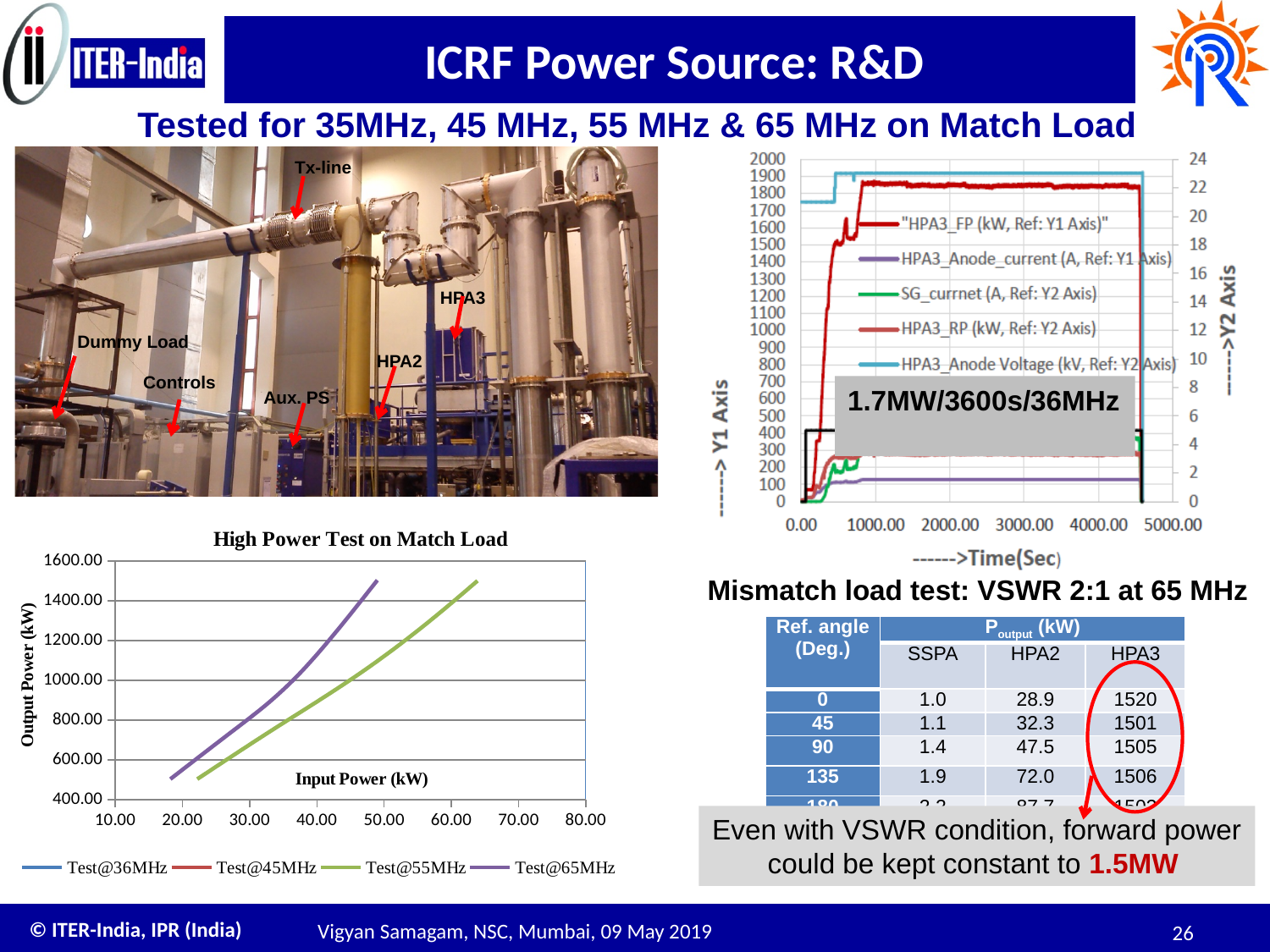
In the top-right time-series chart, is the plateau value of HPA3_FP (kW, Ref: Y1 Axis) greater or less than 1700? greater In the 'High Power Test on Match Load' chart, is the highest output power reached by Test@65MHz greater or less than 1400.00? greater In the top-right time-series chart, what is the label of the x axis? Time(Sec) In the 'High Power Test on Match Load' chart, at an input power of 40.00 kW, which series has the higher output power, Test@65MHz or Test@55MHz? Test@65MHz What kind of chart is the 'High Power Test on Match Load' chart? line chart How many series does the legend of the top-right time-series chart list? 5 In the 'High Power Test on Match Load' chart, what is the label of the x axis? Input Power (kW) In the 'High Power Test on Match Load' chart, is the lowest output power plotted for Test@55MHz greater or less than 600.00? less What kind of chart is the time-series chart at the top right of the slide? line chart How many series does the legend of the 'High Power Test on Match Load' chart list? 4 In the 'High Power Test on Match Load' chart, does output power rise or fall as input power increases? rise In the 'High Power Test on Match Load' chart, what is the label of the y axis? Output Power (kW)